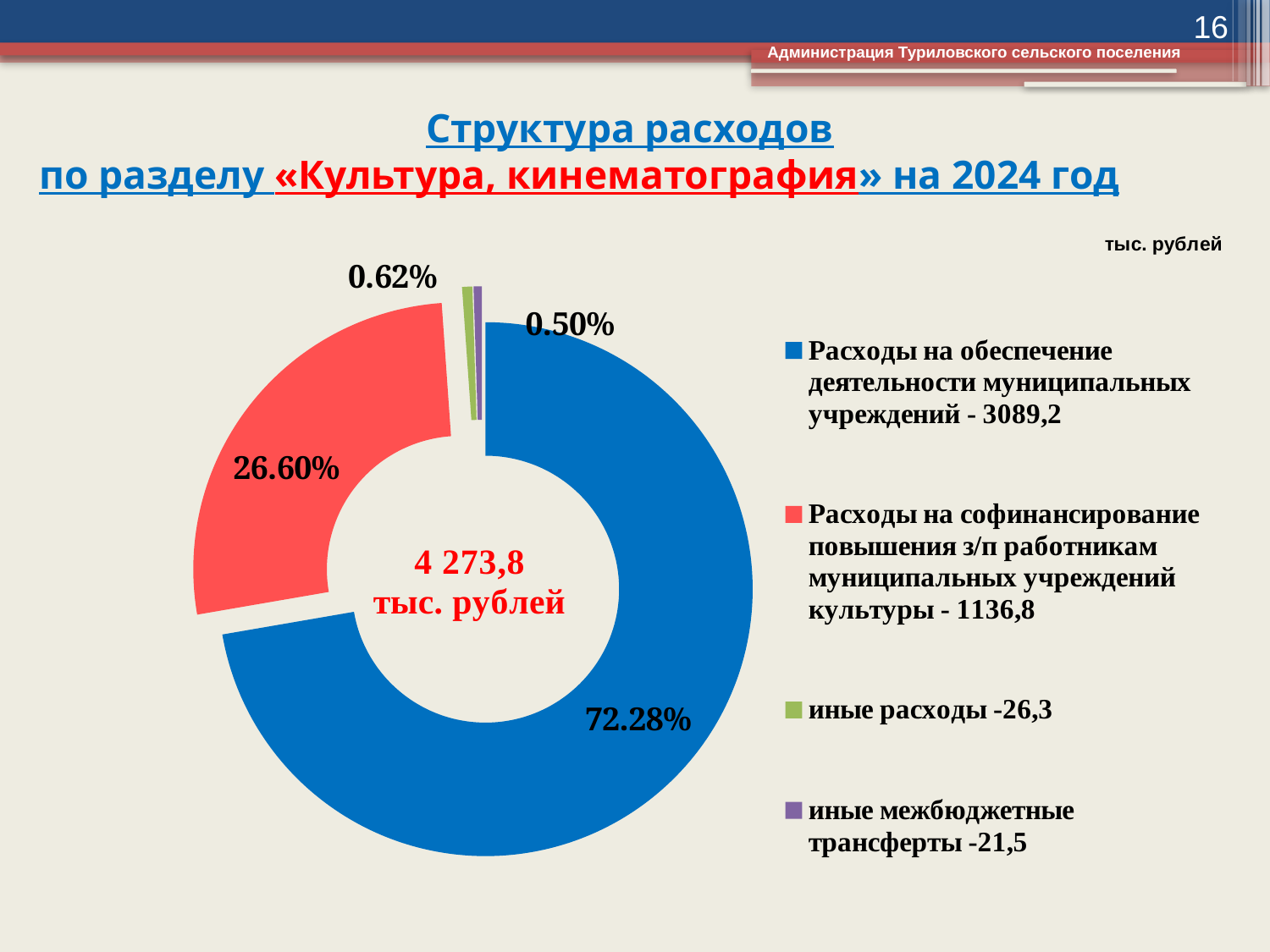
Which category has the smallest share of the chart? иные межбюджетные трансферты What is the difference in тыс. рублей between «Расходы на обеспечение деятельности муниципальных учреждений» (3089,2) and «Расходы на софинансирование повышения з/п работникам муниципальных учреждений культуры» (1136,8)? 1952,4 What is the value (тыс. рублей) for «Расходы на обеспечение деятельности муниципальных учреждений» according to the legend? 3089,2 What share of the chart is taken by «иные межбюджетные трансферты»? 0.50% What share of the doughnut chart is taken by «Расходы на софинансирование повышения з/п работникам муниципальных учреждений культуры»? 26.60% Which category has the largest share of the chart? Расходы на обеспечение деятельности муниципальных учреждений What type of chart is shown on the slide? Doughnut (pie) chart What is the value (тыс. рублей) for «иные межбюджетные трансферты» according to the legend? 21,5 How many categories does the legend of the chart list? 4 What share of the chart is taken by «иные расходы»? 0.62% What is the total amount shown in the centre of the chart? 4 273,8 тыс. рублей